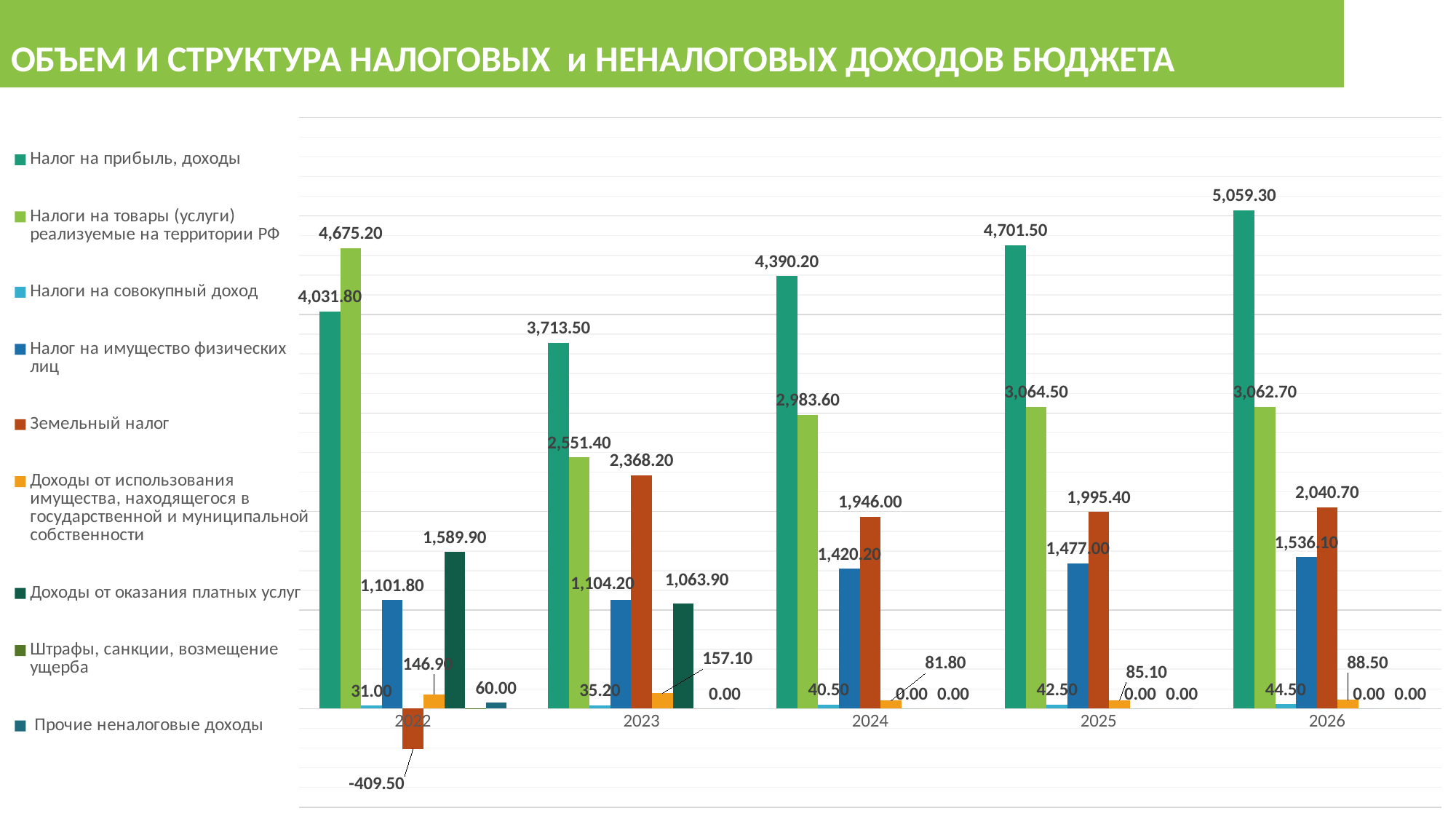
What is the difference between Земельный налог in 2026 and in 2025? 45.30 What is the value of Налоги на совокупный доход for 2024? 40.50 What is the difference between Налог на прибыль, доходы in 2026 and in 2025? 357.80 How many series does the legend list? 9 What is the value of Доходы от оказания платных услуг for 2022? 1,589.90 What is the value of Земельный налог for 2022? -409.50 What kind of chart is shown on the slide? Bar chart How many years are shown on the x axis? 5 In 2022, which is larger: Налог на прибыль, доходы or Налоги на товары (услуги) реализуемые на территории РФ? Налоги на товары (услуги) реализуемые на территории РФ What is the value of Налог на прибыль, доходы for 2026? 5,059.30 In which year is Налог на прибыль, доходы the highest? 2026 In which year is Налог на прибыль, доходы the lowest? 2023